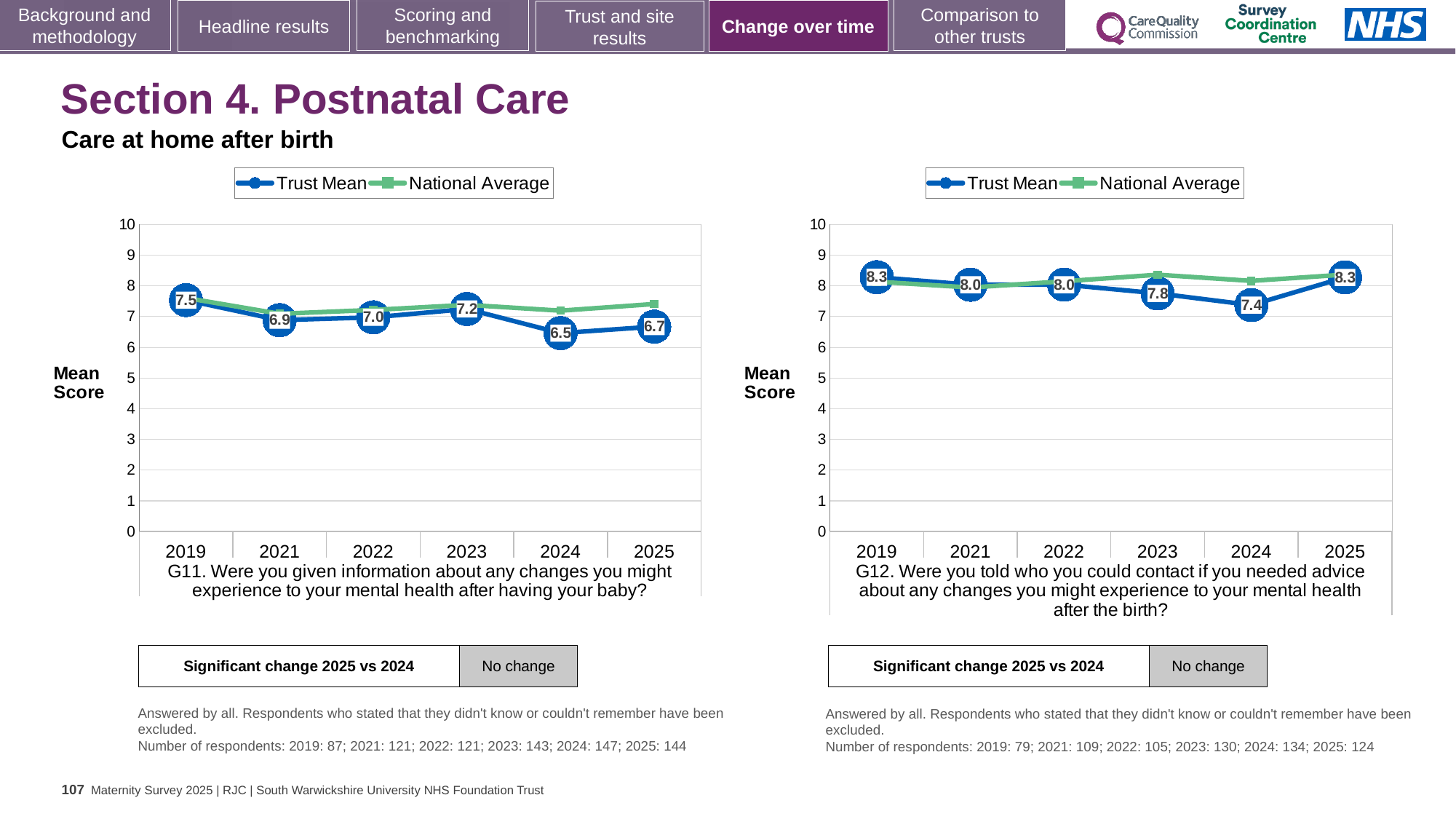
In the left chart (G11), what is the Trust Mean score for 2024? 6.5 In the right chart (G12), which year has the lowest Trust Mean score? 2024 In the right chart (G12), what is the Trust Mean score for 2024? 7.4 In the left chart (G11), what is the Trust Mean score for 2019? 7.5 How many series does the legend of the right chart (G12) list? 2 In the right chart (G12), what is the Trust Mean score for 2023? 7.8 In the left chart (G11), which year has the highest Trust Mean score? 2019 In the right chart (G12), is the National Average for 2023 greater or less than 7? greater In the right chart (G12), is the Trust Mean score for 2021 larger or smaller than the score for 2024? larger In the left chart (G11), what is the difference between the Trust Mean scores for 2019 and 2025? 0.8 In the left chart (G11), which year has the lowest Trust Mean score? 2024 How many years are plotted on the x axis of the left chart (G11)? 6